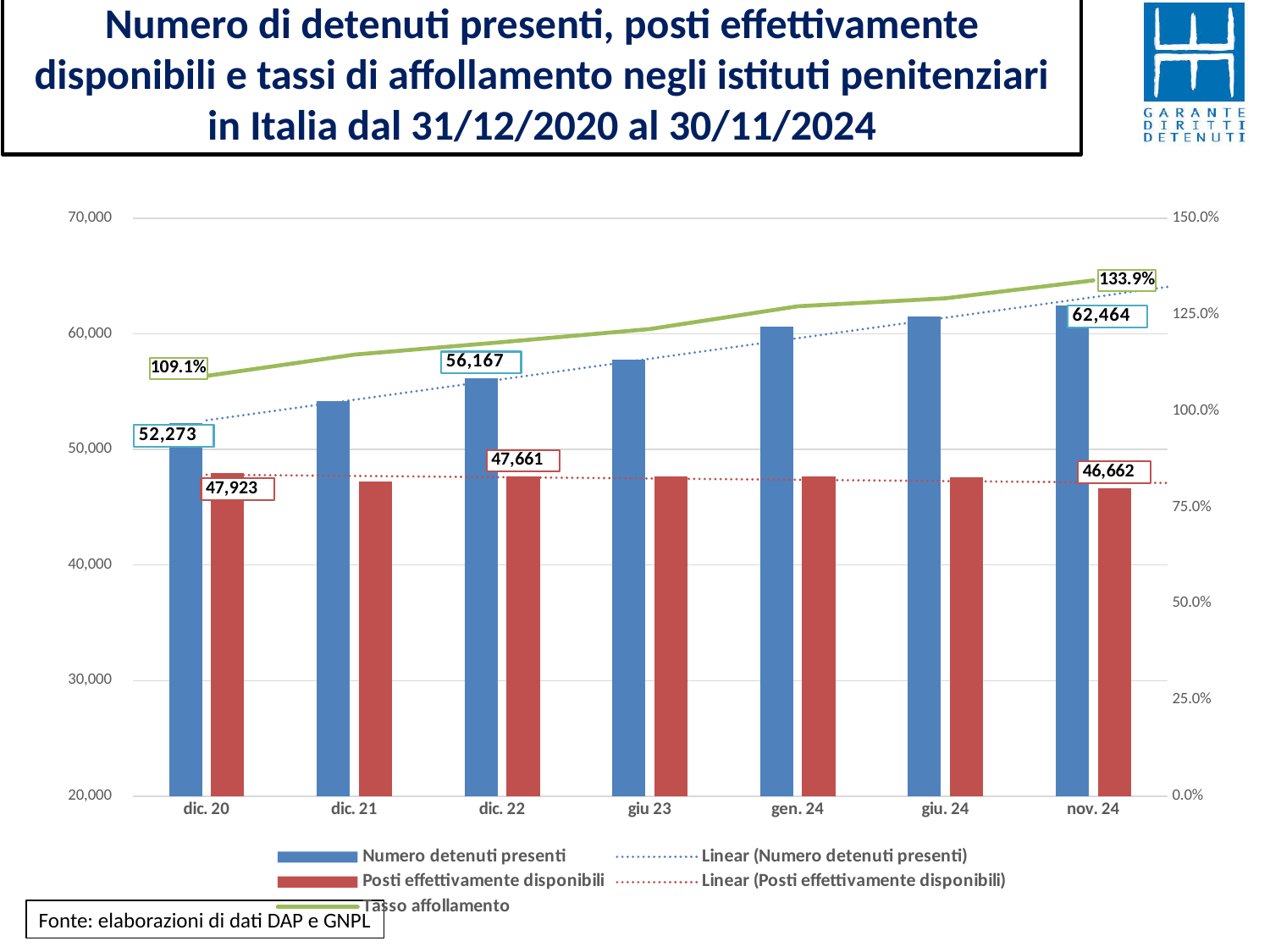
Which is larger for dic. 22: Numero detenuti presenti or Posti effettivamente disponibili? Numero detenuti presenti Which period has the lowest value for Numero detenuti presenti? dic. 20 How many periods are shown on the x axis? 7 What is the difference between Numero detenuti presenti and Posti effettivamente disponibili for nov. 24? 15,802 What is the Tasso affollamento shown for nov. 24? 133.9% What is the value of Numero detenuti presenti for dic. 22? 56,167 What is the value of Numero detenuti presenti for dic. 20? 52,273 Does the Tasso affollamento rise or fall from dic. 20 to nov. 24? rise What is the value of Posti effettivamente disponibili for nov. 24? 46,662 Is the value of Numero detenuti presenti for giu. 24 greater or less than 60,000? greater What is the difference between Numero detenuti presenti for nov. 24 and for dic. 20? 10,191 Which period has the highest value for Numero detenuti presenti? nov. 24